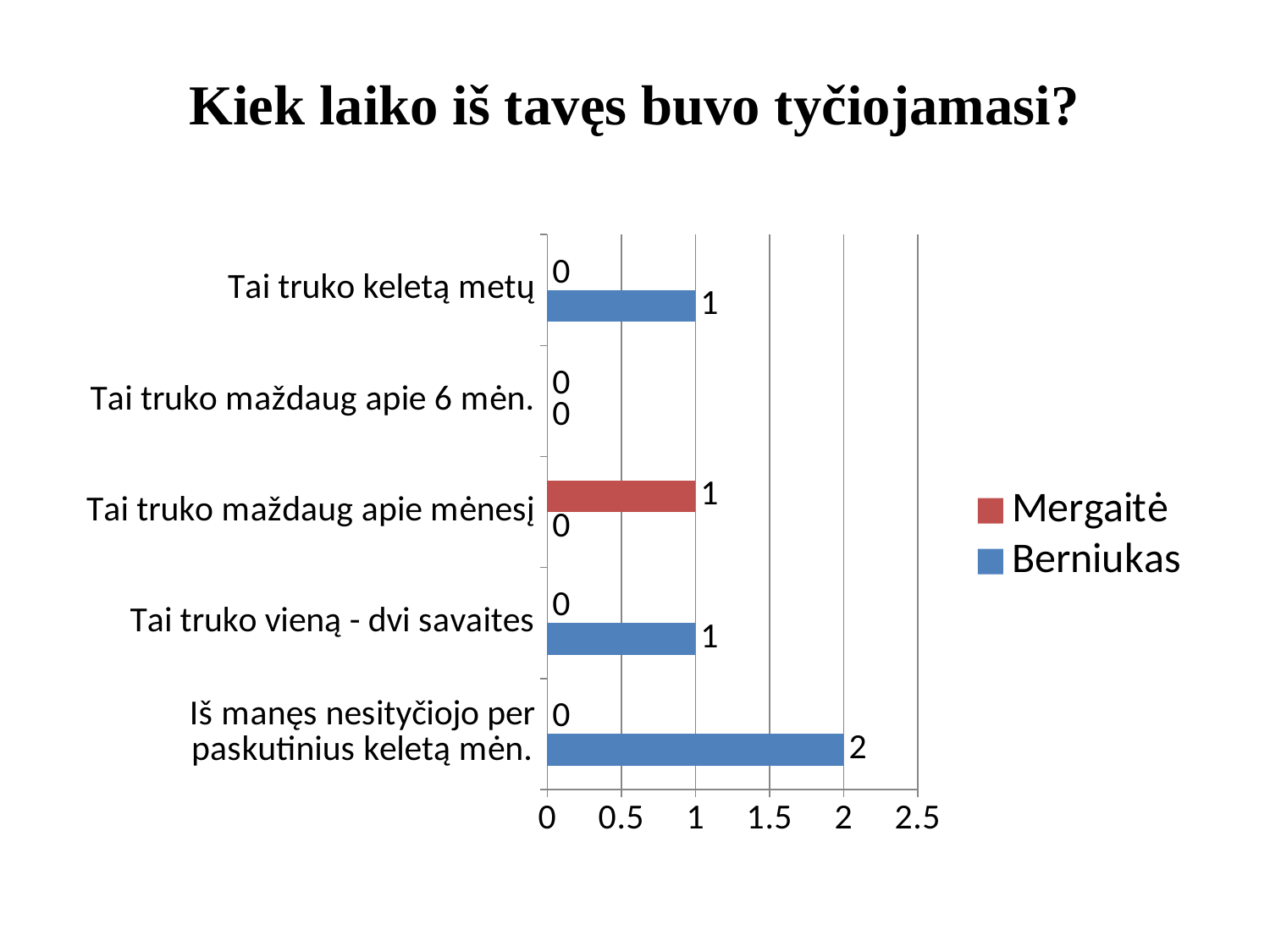
Which category has the highest value for Mergaitė? Tai truko maždaug apie mėnesį What kind of chart is shown on the slide? Bar chart What is the title of the chart? Kiek laiko iš tavęs buvo tyčiojamasi? What is the difference between the Berniukas values for "Iš manęs nesityčiojo per paskutinius keletą mėn." and "Tai truko keletą metų"? 1 Which is larger: the Berniukas value for "Tai truko vieną - dvi savaites" or the Berniukas value for "Iš manęs nesityčiojo per paskutinius keletą mėn."? Iš manęs nesityčiojo per paskutinius keletą mėn. What is the value for Mergaitė in the category "Tai truko maždaug apie mėnesį"? 1 What is the value for Mergaitė in the category "Tai truko vieną - dvi savaites"? 0 Which category has the highest value for Berniukas? Iš manęs nesityčiojo per paskutinius keletą mėn. How many categories are shown on the chart? 5 What is the value for Berniukas in the category "Iš manęs nesityčiojo per paskutinius keletą mėn."? 2 What is the value for Berniukas in the category "Tai truko keletą metų"? 1 How many series does the legend list? 2